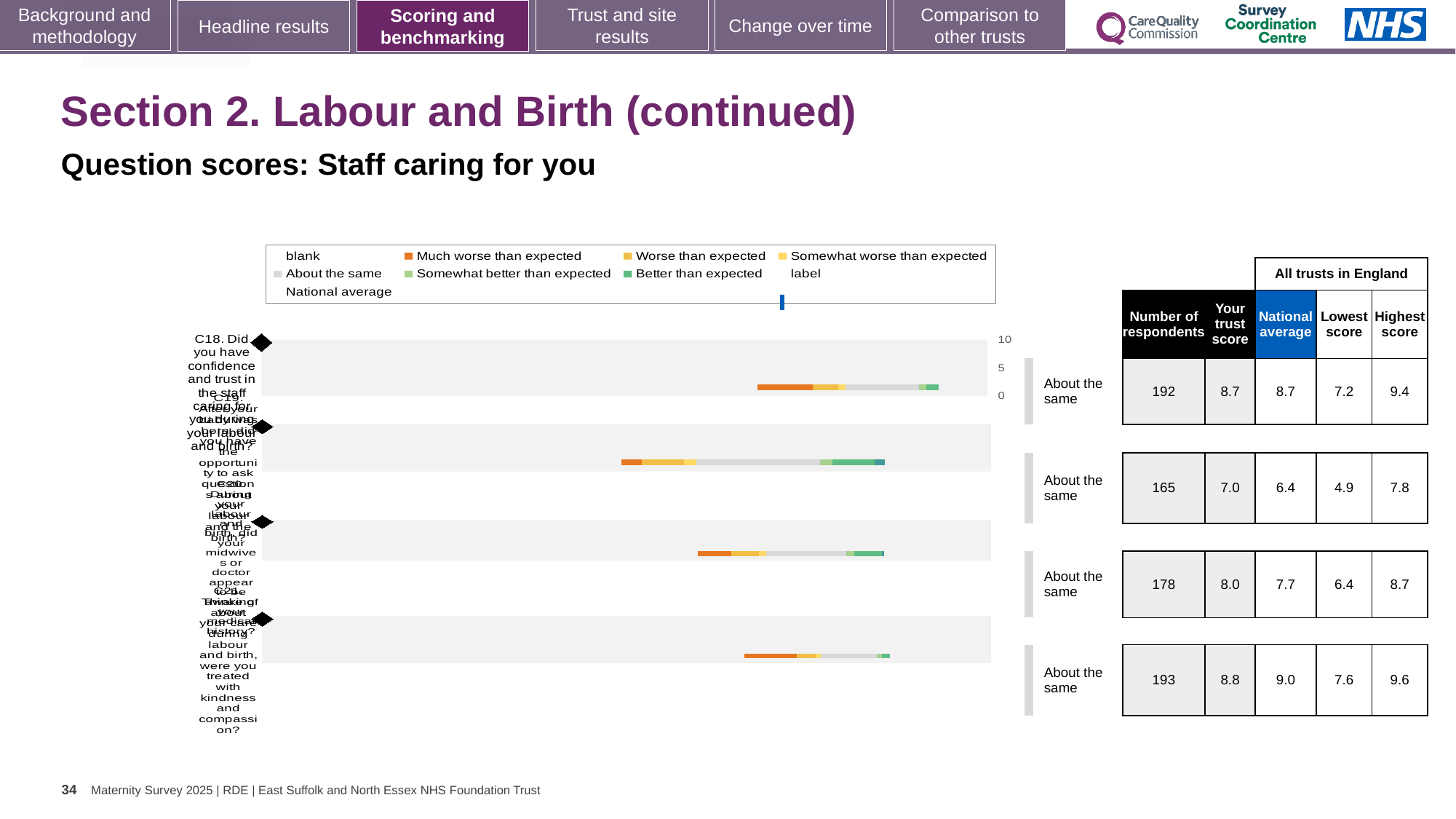
What is the highest score among all trusts in England for the third row of the chart? 8.7 What kind of chart is shown on the slide? bar chart What is the difference between the highest and lowest scores for the second row? 2.9 What is the difference between the trust score and the national average for the second row? 0.6 How many question rows (categories) are plotted in the chart? 4 What is the number of respondents for the fourth row of the chart? 193 Which row has the lowest trust score? the second row (C19) Is the trust score for the fourth row larger or smaller than its national average? smaller Which row has the highest trust score? the fourth row (C21) What benchmark category is shown for every row of the chart? About the same What is the national average for the second row of the chart? 6.4 What is the trust score for the first row (C18, confidence and trust in the staff caring for you)? 8.7